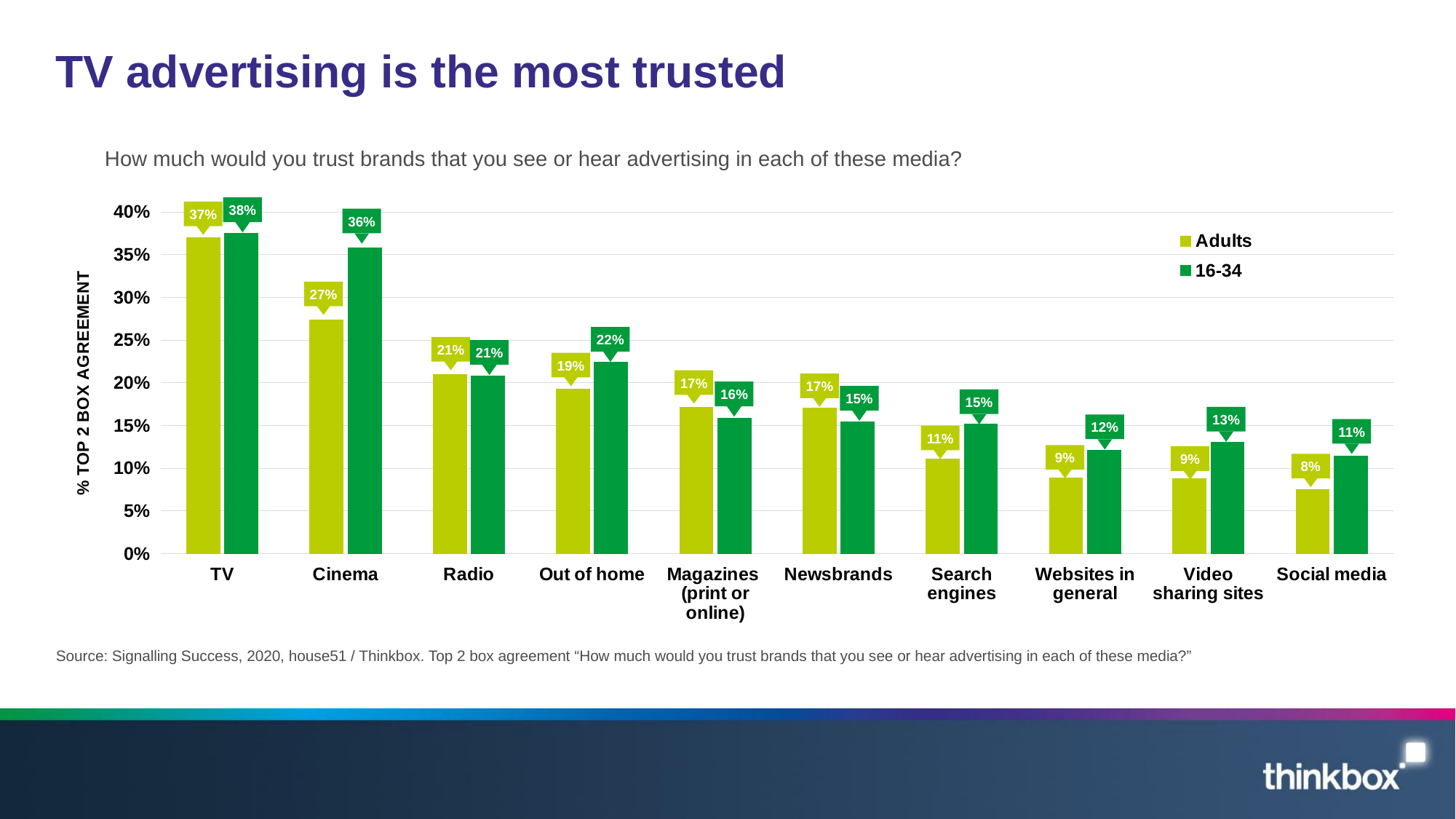
Which is larger for Search engines: the Adults value or the 16-34 value? 16-34 Which category has the lowest value for the Adults series? Social media What is the value for 16-34 for Cinema? 36% What is the value for Adults for TV? 37% What is the label of the vertical axis? % TOP 2 BOX AGREEMENT What is the difference between the Adults and 16-34 values for Cinema? 9% Which category has the highest value for the 16-34 series? TV What kind of chart is shown on the slide? Bar chart How many series does the legend list? 2 What is the value for Adults for Social media? 8% What is the value for 16-34 for Video sharing sites? 13% How many media categories are shown on the x axis? 10